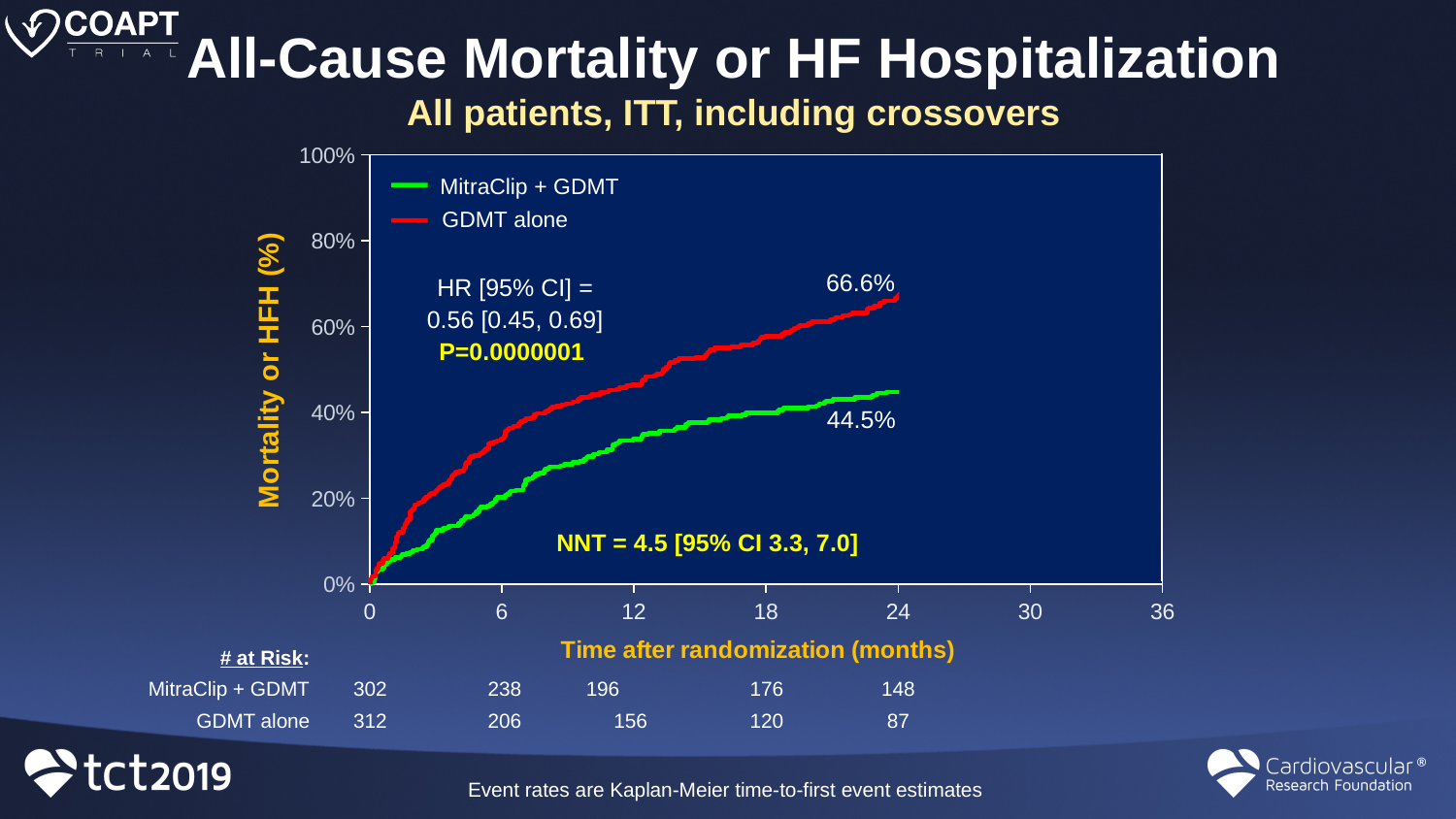
What is the difference between the GDMT alone and MitraClip + GDMT event rates at 24 months? 22.1% Is the value for GDMT alone at 12 months greater or less than 40%? greater What is the event rate for GDMT alone at 24 months? 66.6% Do the event rate curves rise or fall as time after randomization increases? Rise How many patients were at risk in the GDMT alone group at 24 months? 87 Which group has the higher event rate at 24 months, GDMT alone or MitraClip + GDMT? GDMT alone What is the event rate for MitraClip + GDMT at 24 months? 44.5% How many series does the legend list? 2 Is the value for MitraClip + GDMT at 12 months greater or less than 40%? less What kind of chart is shown on the slide? Line chart What colour is the line for GDMT alone? Red How many patients were at risk in the MitraClip + GDMT group at 12 months? 196